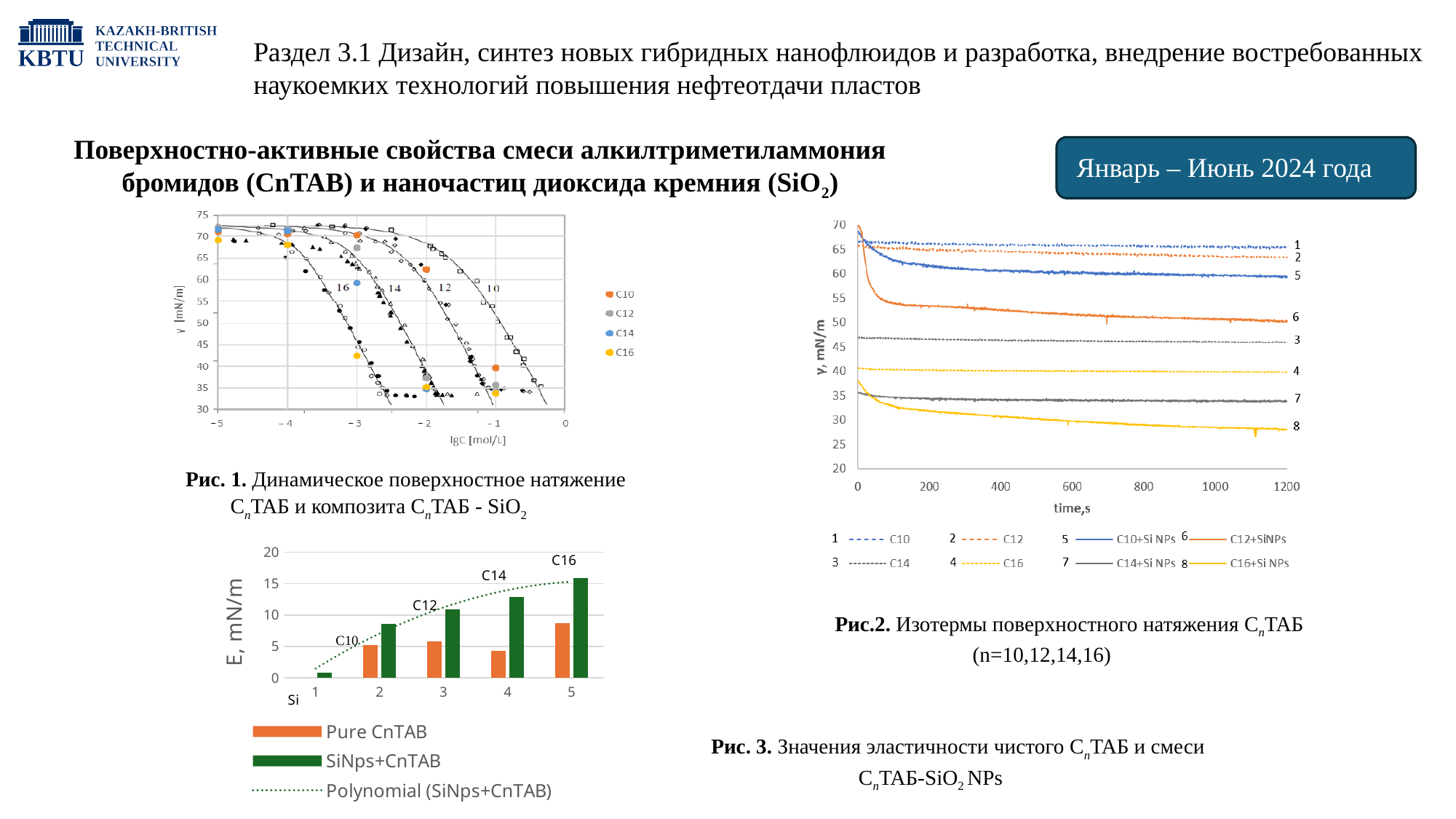
How many series does the legend of Рис. 3 (bottom-left chart) list? 3 In Рис. 3 (bottom-left chart), at category 5, which is larger: the Pure CnTAB bar or the SiNps+CnTAB bar? SiNps+CnTAB What kind of chart is Рис. 3 (the chart at the bottom left)? bar chart In Рис. 3 (bottom-left chart), which category on the x axis has the tallest SiNps+CnTAB bar? 5 In Рис. 3 (bottom-left chart), is the Pure CnTAB value at category 5 greater or less than 10? less In Рис. 3 (bottom-left chart), do the SiNps+CnTAB bars rise or fall from category 1 to category 5? rise In Рис. 3 (bottom-left chart), is the SiNps+CnTAB value at category 4 greater or less than 10? greater In Рис. 2 (the chart on the right), is the value of the C16+Si NPs line (curve 8) at 1200 s greater or less than 30? less In Рис. 2 (the chart on the right), which series has the lowest surface tension at 1200 s? C16+Si NPs How many entries does the legend of Рис. 1 (the top-left chart) list? 4 How many series does the legend of Рис. 2 (the chart on the right) list? 8